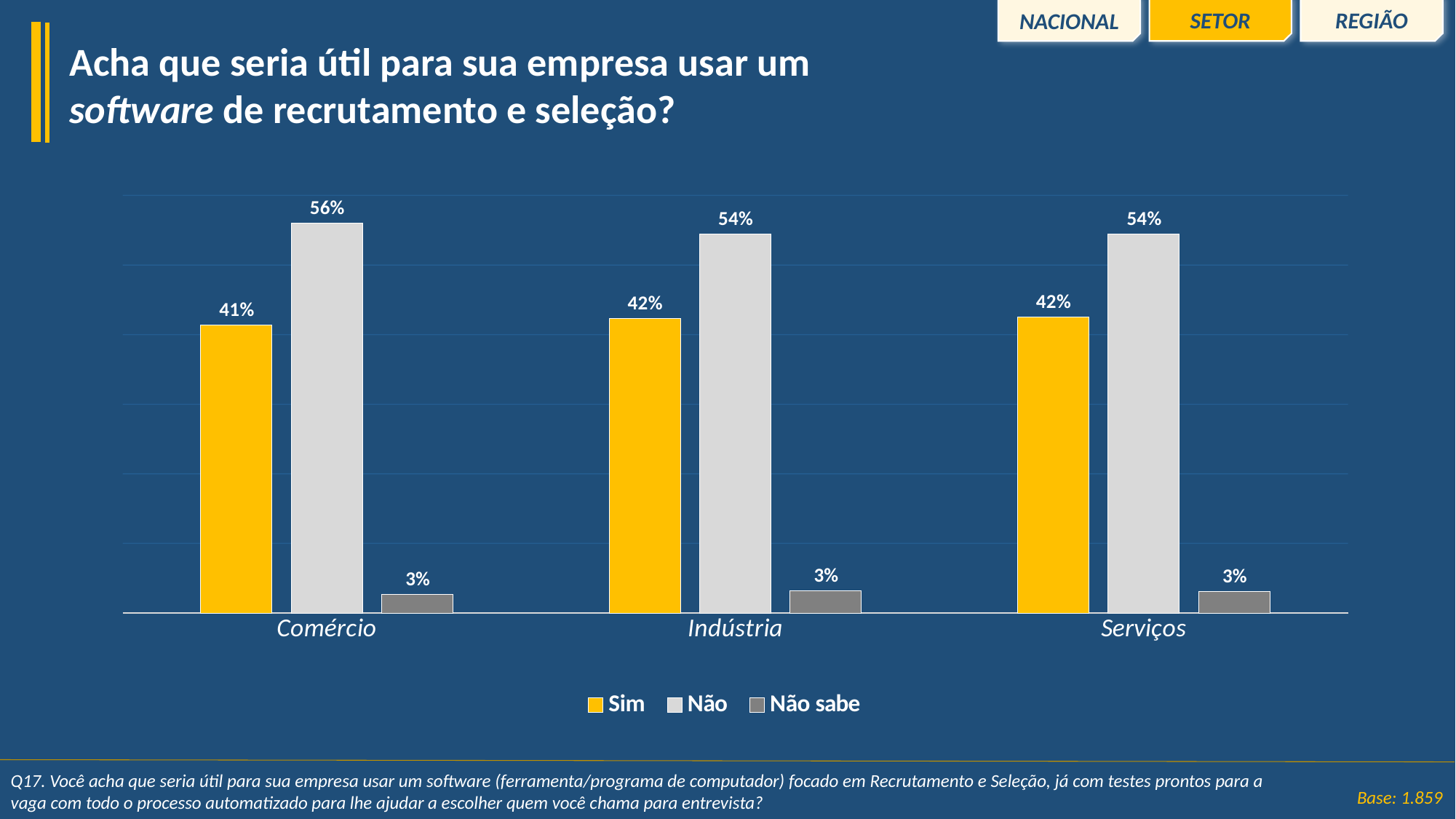
How many sectors are shown on the x axis? 3 What is the value for Não in Indústria? 54% What kind of chart is shown on the slide? Bar chart Which sector has the lowest value for Sim? Comércio What is the value for Sim in Comércio? 41% What is the difference between Não and Sim in Serviços? 12% How many series does the legend list? 3 What is the value for Não in Comércio? 56% Which sector has the highest value for Não? Comércio What is the difference between Não and Sim in Comércio? 15% What is the value for Não sabe in Serviços? 3% Which is larger in Indústria, Sim or Não? Não